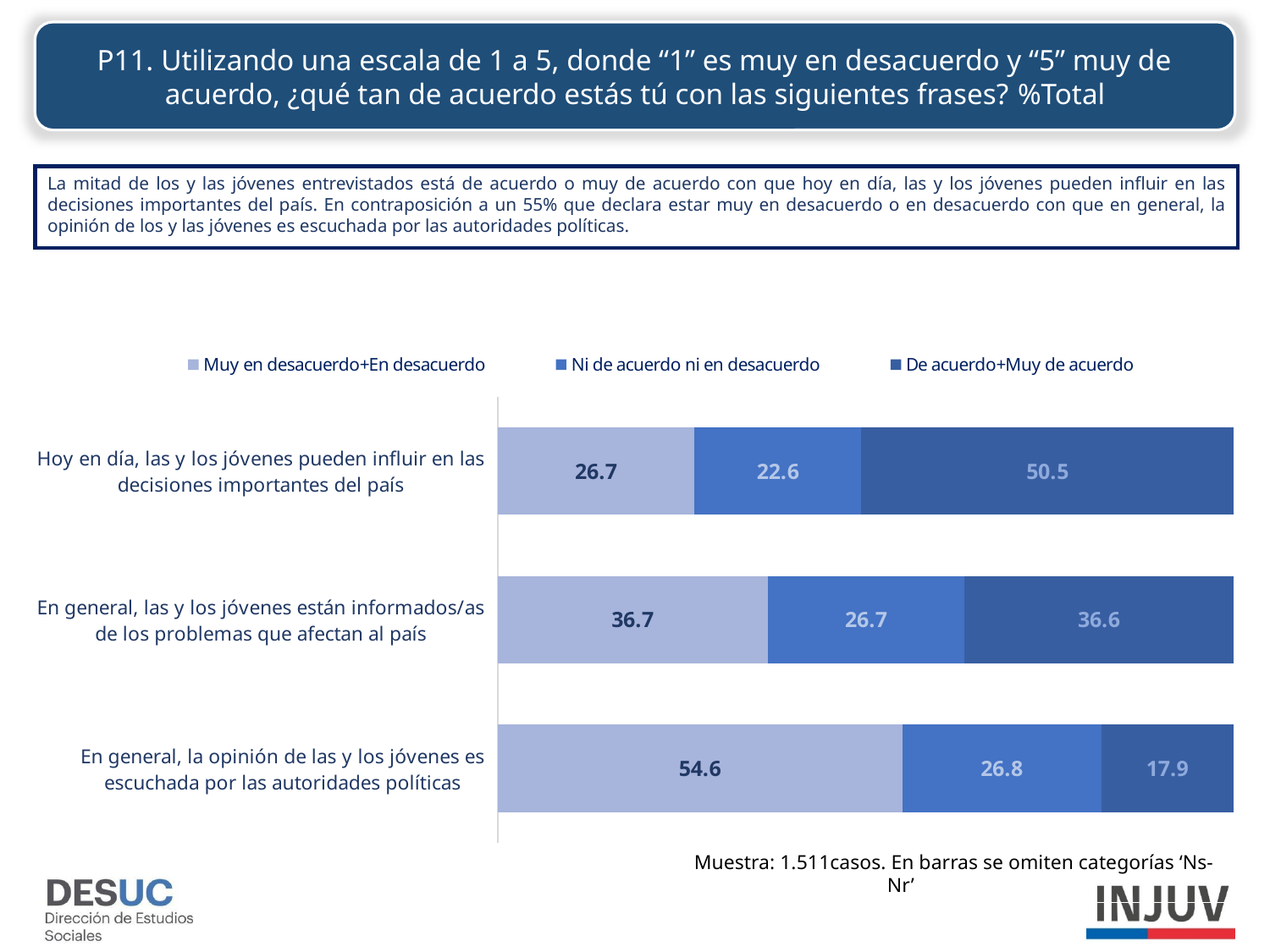
Which legend entry is shown in the lightest blue colour? Muy en desacuerdo+En desacuerdo What is the value of 'De acuerdo+Muy de acuerdo' for 'Hoy en día, las y los jóvenes pueden influir en las decisiones importantes del país'? 50.5 Which statement has the lowest 'Muy en desacuerdo+En desacuerdo' value? Hoy en día, las y los jóvenes pueden influir en las decisiones importantes del país What is the value of 'Ni de acuerdo ni en desacuerdo' for 'En general, las y los jóvenes están informados/as de los problemas que afectan al país'? 26.7 How many series does the legend list? 3 What is the difference between the 'De acuerdo+Muy de acuerdo' values for 'Hoy en día, las y los jóvenes pueden influir en las decisiones importantes del país' and 'En general, la opinión de las y los jóvenes es escuchada por las autoridades políticas'? 32.6 What is the value of 'Muy en desacuerdo+En desacuerdo' for 'En general, la opinión de las y los jóvenes es escuchada por las autoridades políticas'? 54.6 What kind of chart is shown on the slide? Stacked bar chart Which statement has the highest 'De acuerdo+Muy de acuerdo' value? Hoy en día, las y los jóvenes pueden influir en las decisiones importantes del país Which is larger: 'Muy en desacuerdo+En desacuerdo' for 'En general, las y los jóvenes están informados/as de los problemas que afectan al país' or 'De acuerdo+Muy de acuerdo' for the same statement? Muy en desacuerdo+En desacuerdo How many statements (categories) are plotted in the chart? 3 What is the total of the stacked bar for 'En general, las y los jóvenes están informados/as de los problemas que afectan al país'? 100.0